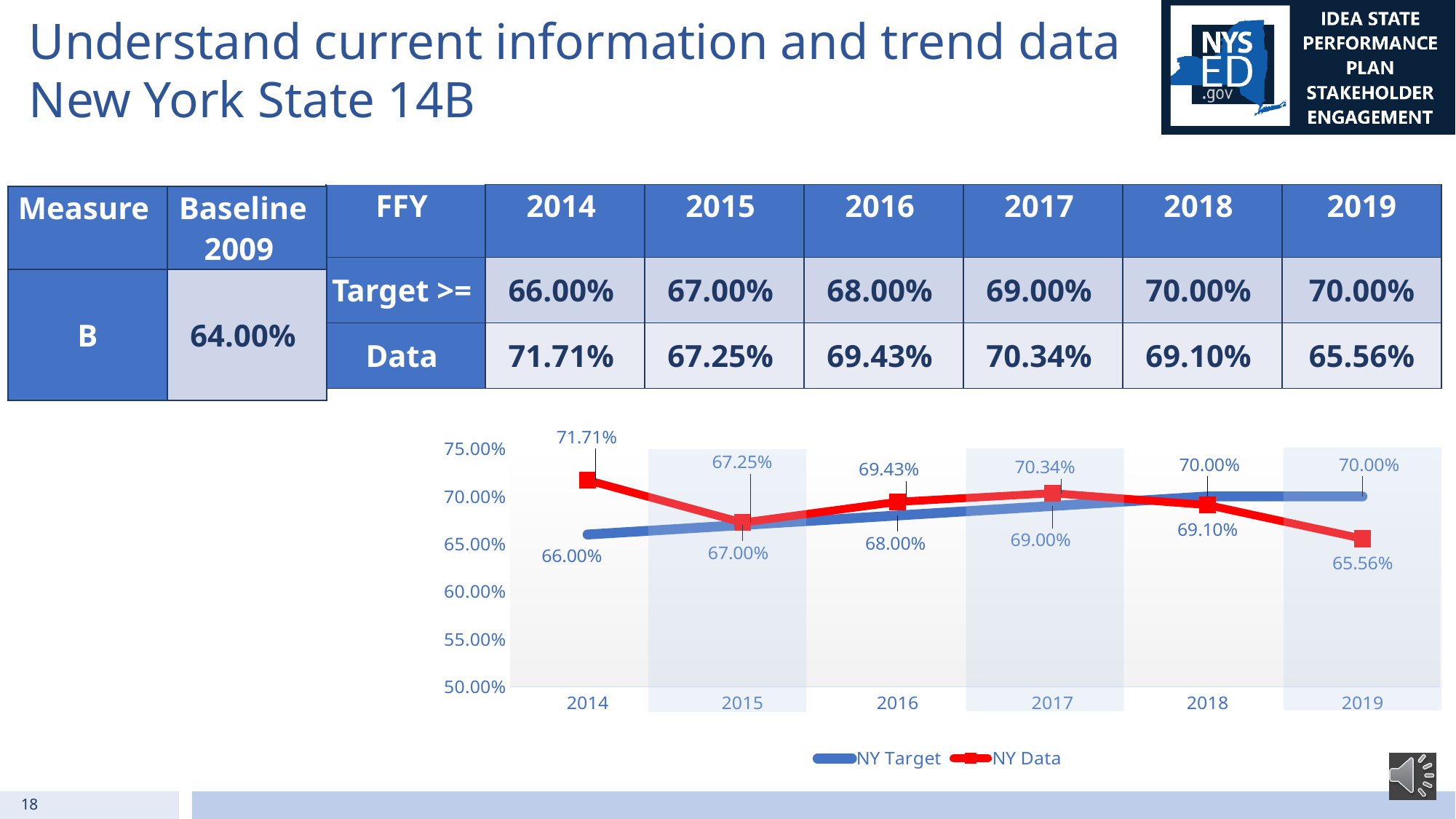
In which year is the NY Data value lowest? 2019 How many years are shown on the x axis of the chart? 6 How many series does the chart legend list? 2 What is the NY Data value for 2014? 71.71% What is the NY Target value for 2017? 69.00% What kind of chart is shown on the slide? line chart Is the NY Data value for 2019 greater or less than 70.00%? less What is the difference between the NY Data and NY Target values in 2014? 5.71% Does the NY Target series rise or fall from 2014 to 2018? rise What is the NY Data value for 2019? 65.56% In which year is the NY Data value highest? 2014 Which is larger in 2019, NY Target or NY Data? NY Target